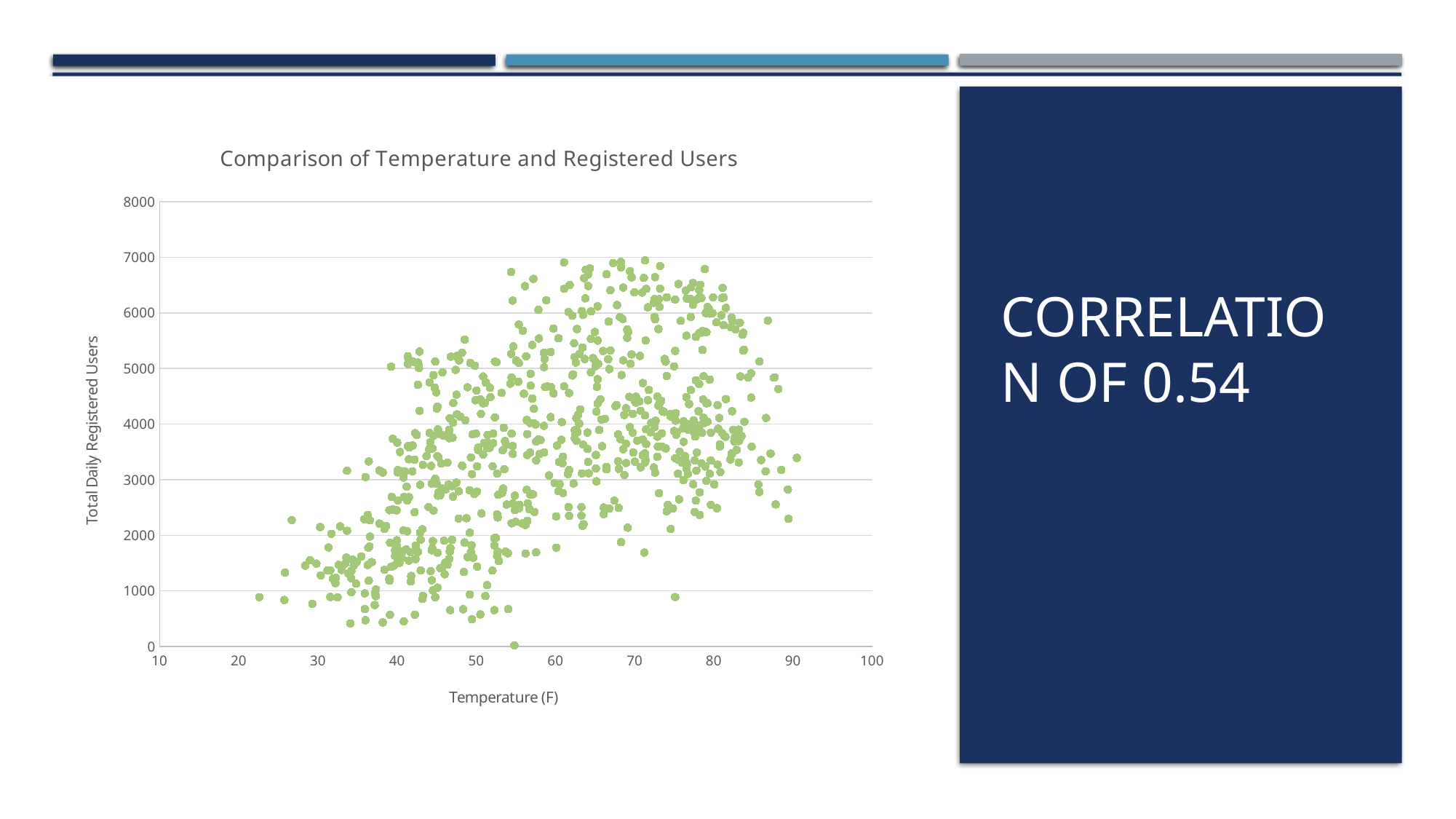
What is the title of the chart? Comparison of Temperature and Registered Users Are any points plotted above 8000 on the y axis? no What kind of chart is shown on the slide? scatter chart As temperature increases along the x axis, do the total daily registered users generally rise or fall? rise Is the highest tick shown on the y axis greater or less than 7000? greater What correlation value is stated on the slide for temperature and registered users? 0.54 What is the label of the x axis of the chart? Temperature (F)